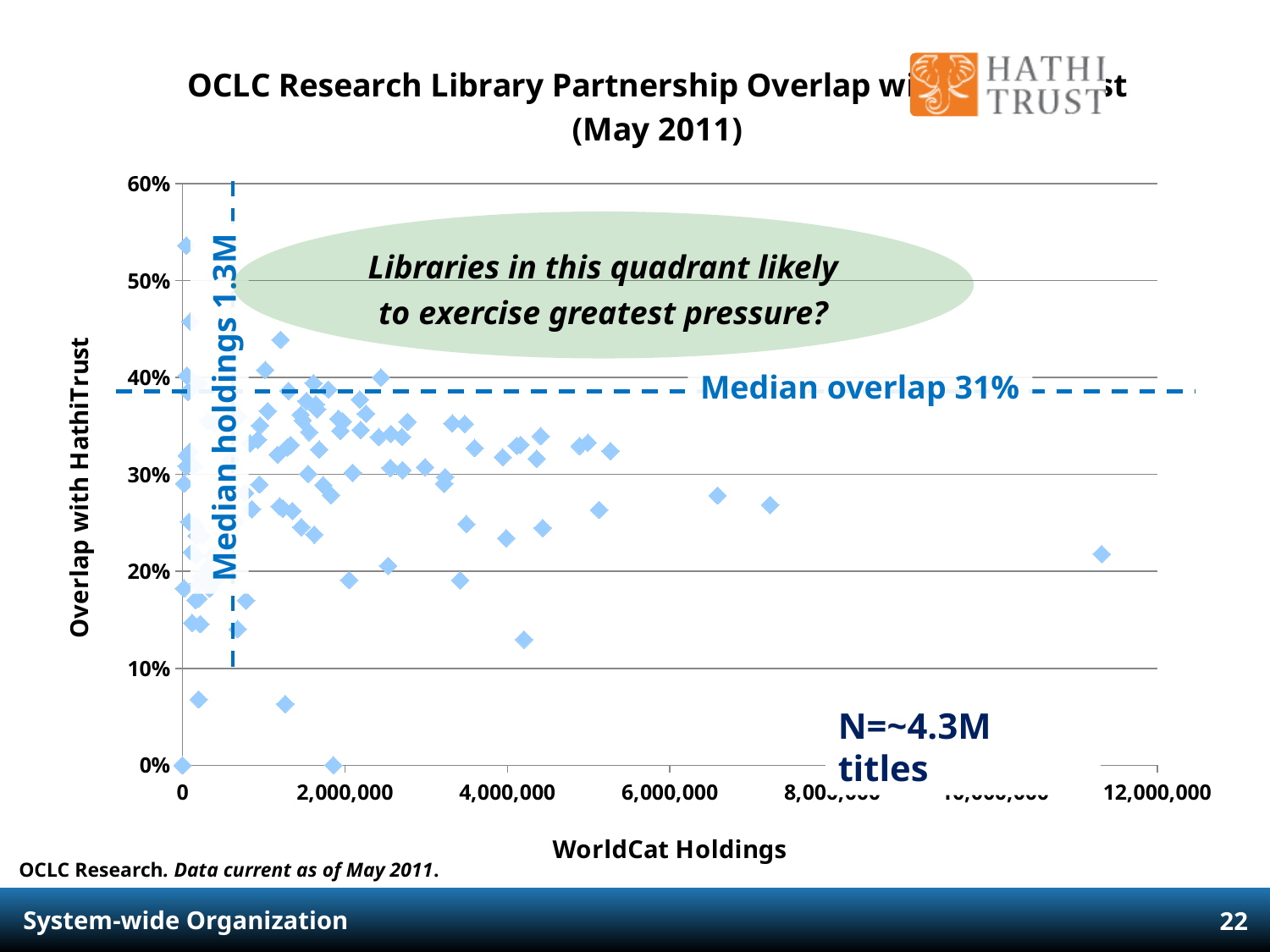
Is the highest overlap value plotted on the chart greater or less than 50%? greater Is the median overlap line greater or less than 40%? less What is the median holdings value marked by the vertical dashed line? 1.3M Is the overlap for the library with the largest WorldCat holdings greater or less than 30%? less What is the label of the y axis? Overlap with HathiTrust Do the libraries with WorldCat holdings above 6,000,000 fall above or below the median overlap line? below What is the N value (number of titles) noted on the chart? ~4.3M titles What kind of chart is shown on the slide? scatter chart What is the label of the x axis? WorldCat Holdings What is the median overlap with HathiTrust shown on the chart? 31%